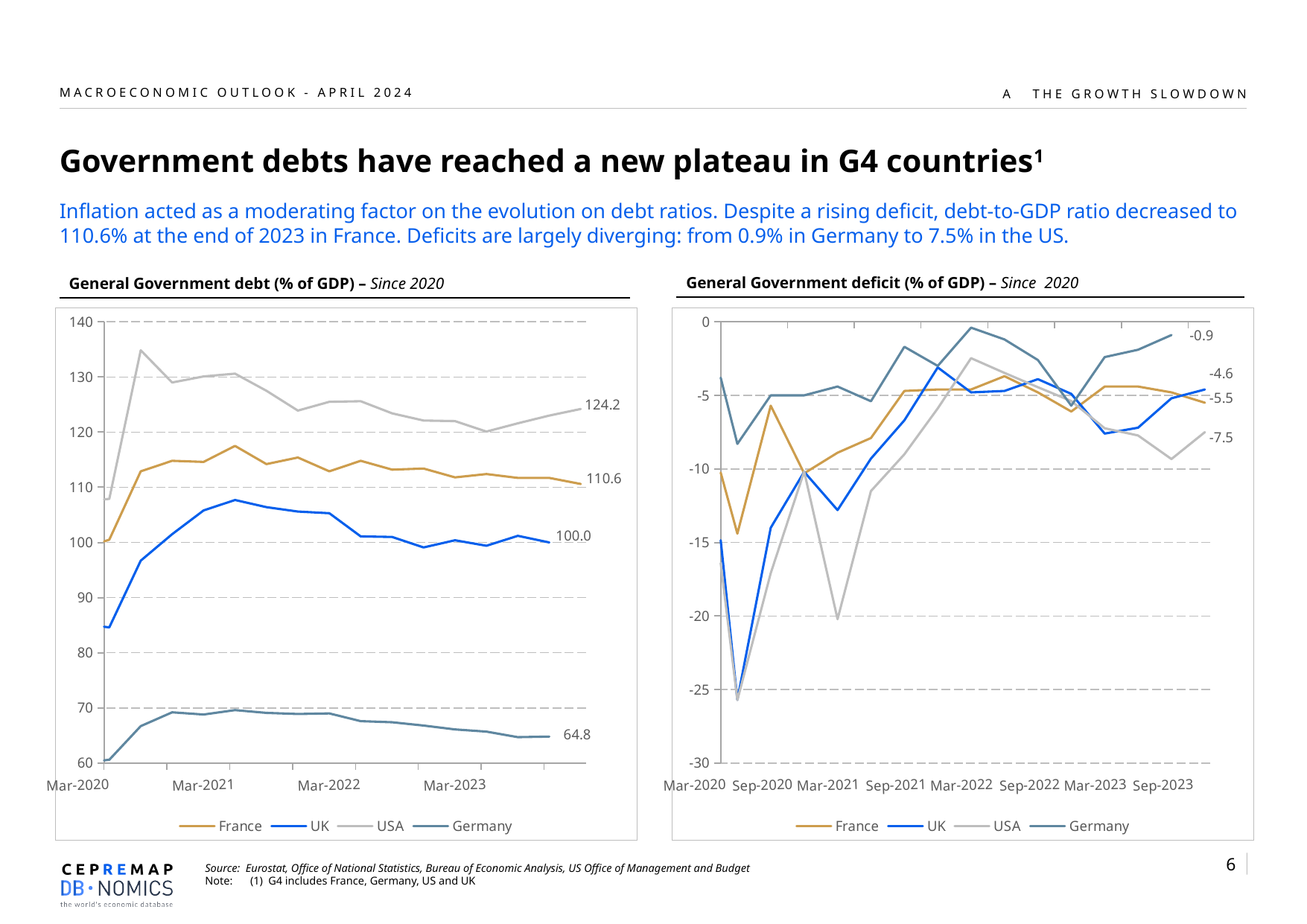
In the General Government deficit chart, what is the difference between the final values for France and the UK? 0.9 How many series does the legend of the General Government deficit chart list? 4 In the General Government deficit chart, what is the labelled final value for the USA? -7.5 In the General Government debt chart, what is the difference between the final values for France and the UK? 10.6 In the General Government debt chart, is the value for the UK at Mar-2020 greater or less than 90? less In the General Government debt chart, what is the labelled final value for Germany? 64.8 In the General Government deficit chart, what is the labelled final value for Germany? -0.9 What kind of chart is the General Government debt chart? line chart In the General Government deficit chart, is the value for the USA at Mar-2021 greater or less than -15? less In the General Government debt chart, which country has the lowest debt ratio at the end of the series? Germany In the General Government debt chart, which country has the highest debt ratio at the end of the series? USA In the General Government debt chart, what is the labelled final value for the USA? 124.2